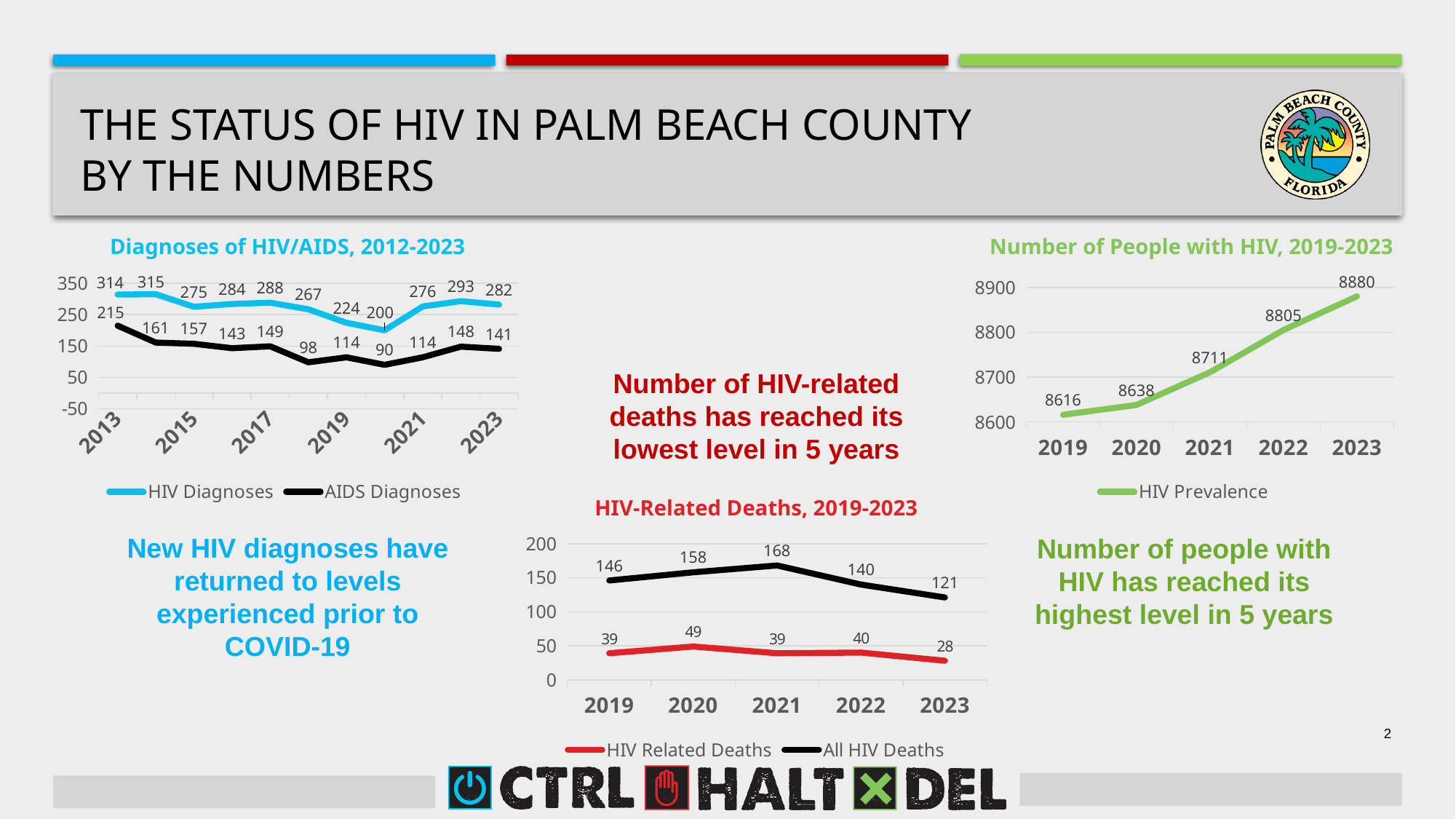
In the 'HIV-Related Deaths, 2019-2023' chart, which year has the highest value for All HIV Deaths? 2021 In the 'HIV-Related Deaths, 2019-2023' chart, which year has the lowest value for HIV Related Deaths? 2023 In the 'HIV-Related Deaths, 2019-2023' chart, what is the value of HIV Related Deaths in 2023? 28 In the 'Number of People with HIV, 2019-2023' chart, what is the difference between the 2023 and 2019 values? 264 What kind of chart is the 'Number of People with HIV, 2019-2023' chart? line chart In the 'Number of People with HIV, 2019-2023' chart, what is the value for 2019? 8616 In the 'Diagnoses of HIV/AIDS, 2012-2023' chart, what is the lowest value of the AIDS Diagnoses series? 90 In the 'HIV-Related Deaths, 2019-2023' chart, what is the value of All HIV Deaths in 2021? 168 In the 'Number of People with HIV, 2019-2023' chart, what is the HIV prevalence value for 2023? 8880 In the 'HIV-Related Deaths, 2019-2023' chart, how many series does the legend list? 2 In the 'Diagnoses of HIV/AIDS, 2012-2023' chart, what is the highest value of the HIV Diagnoses series? 315 In the 'Number of People with HIV, 2019-2023' chart, do the values rise or fall from 2019 to 2023? rise